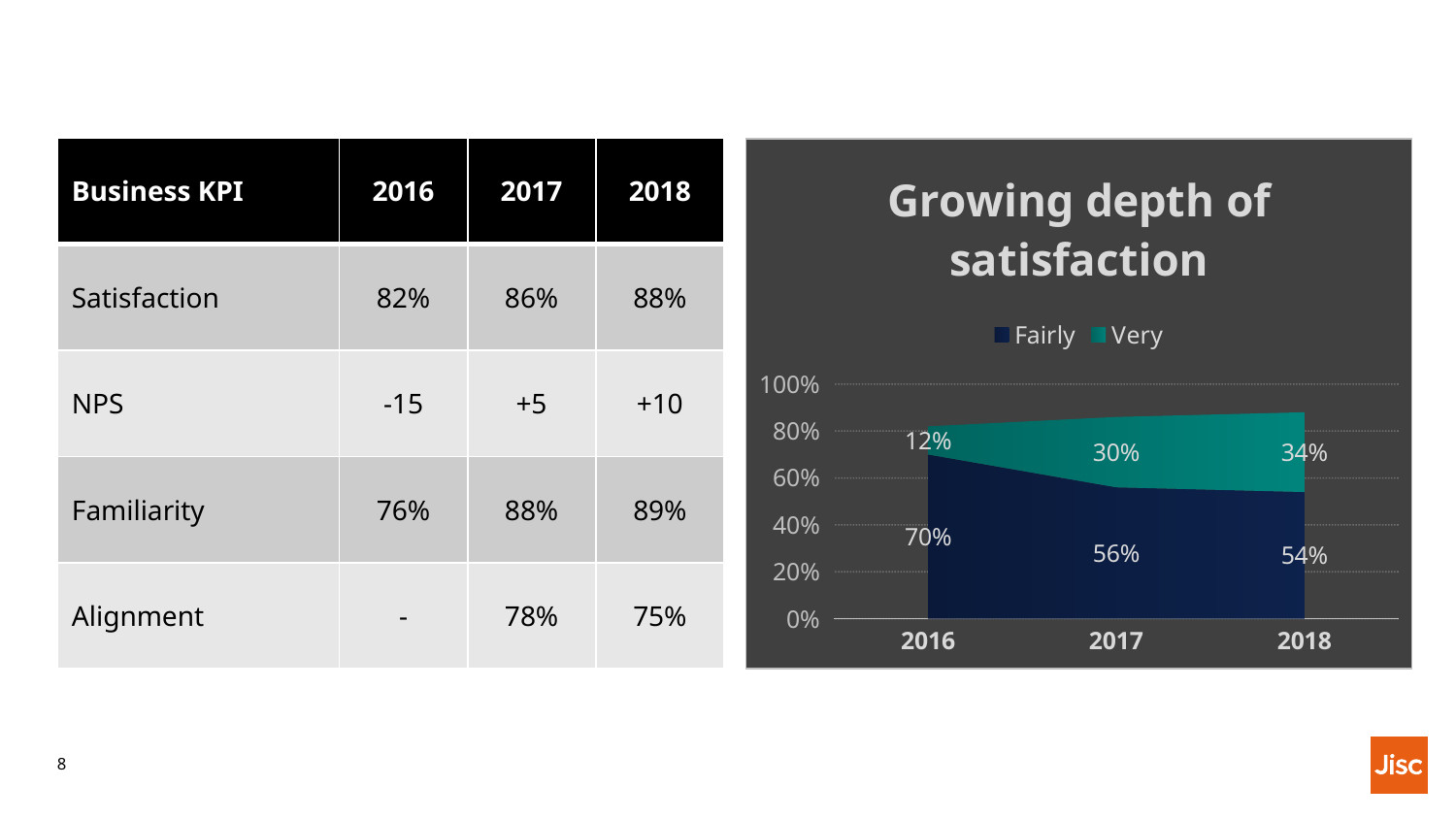
Which is larger in 2017, Fairly or Very? Fairly What kind of chart is shown on the slide? Stacked area chart What is the value for Fairly in 2016? 70% How many series does the chart legend list? 2 What is the value for Very in 2018? 34% What is the value for Very in 2017? 30% What is the difference between the Very values for 2018 and 2016? 22% In which year is the Very series highest? 2018 What is the combined total of Fairly and Very in 2017? 86% What is the value for Fairly in 2018? 54% In which year is the Fairly series lowest? 2018 How many years are shown on the x axis of the chart? 3